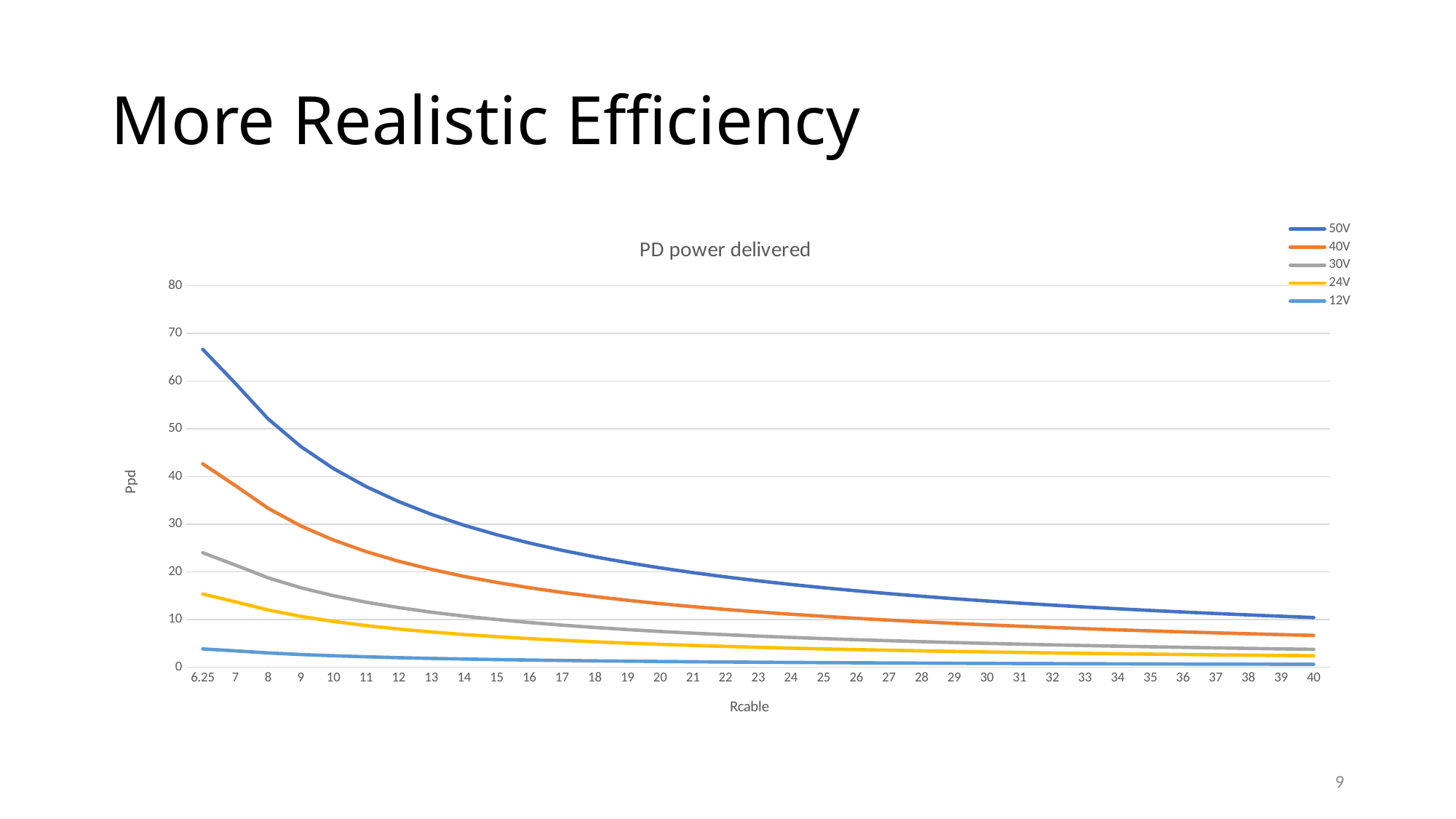
How many Rcable points are plotted along the x axis? 35 At Rcable 6.25, which is larger, the value for 30V or the value for 24V? 30V How many series does the legend list? 5 Is the value for 50V at Rcable 6.25 greater or less than 60? greater Is the value for 40V at Rcable 6.25 greater or less than 40? greater Do the Ppd values rise or fall as Rcable increases? fall Is the value for 12V at Rcable 6.25 greater or less than 10? less Which series has the highest Ppd at Rcable 6.25? 50V Which series has the lowest Ppd across the chart? 12V What is the title of the chart? PD power delivered What kind of chart is shown on the slide? line chart